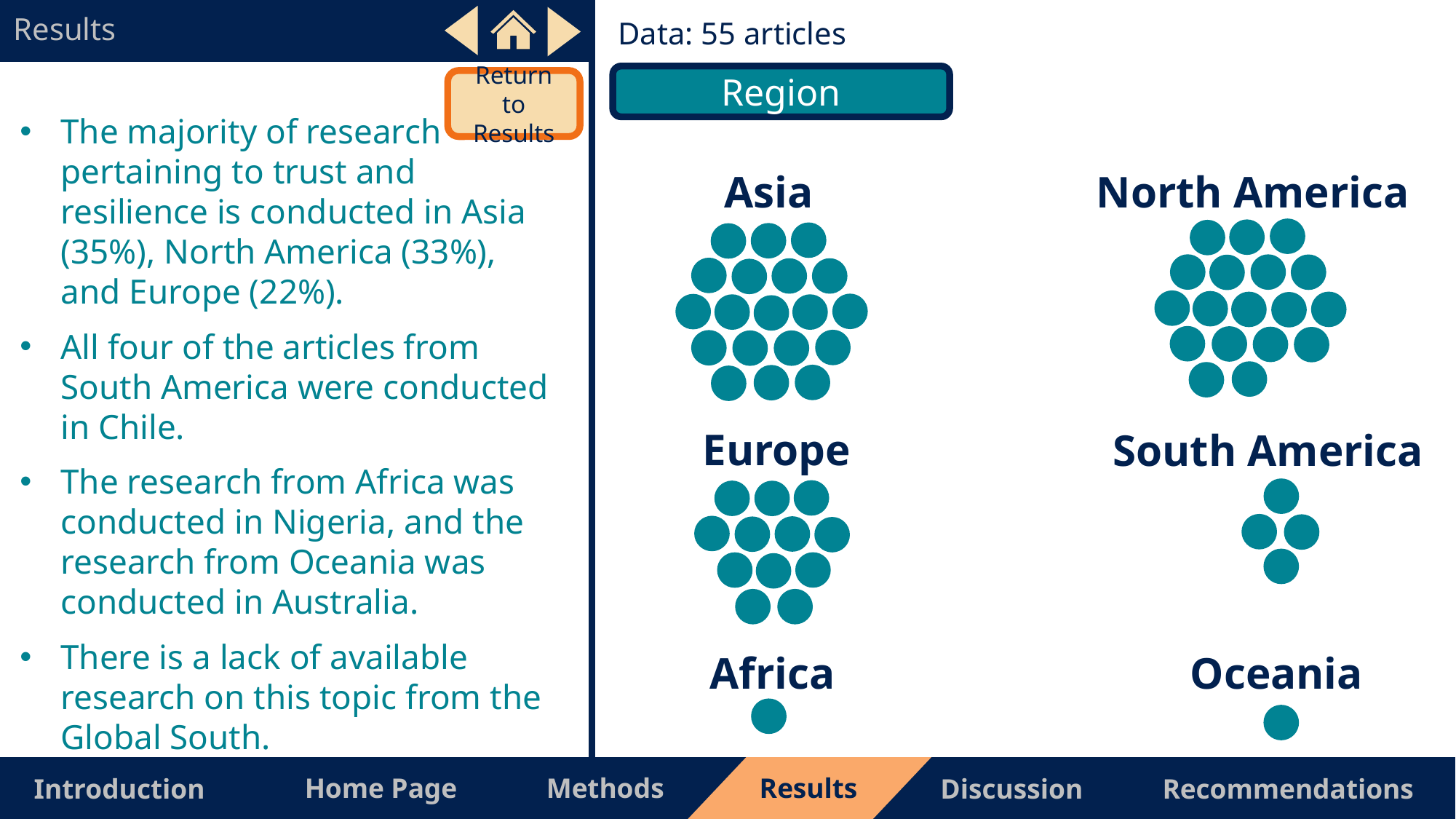
How many dots are shown for South America? 4 How many regions are shown in the Region chart? 6 How many articles does the chart's data cover in total, as stated on the slide? 55 articles What colour are the dots in the Region chart? Teal Which region has the most dots in the Region chart? Asia Which has more dots, Europe or South America? Europe How many dots are shown for Oceania? 1 How many dots are shown for Africa? 1 What is the title shown above the chart? Region Which has more dots, Asia or Europe? Asia Which has more dots, South America or Oceania? South America What kind of chart is used to show articles by region? Dot (pictogram) chart